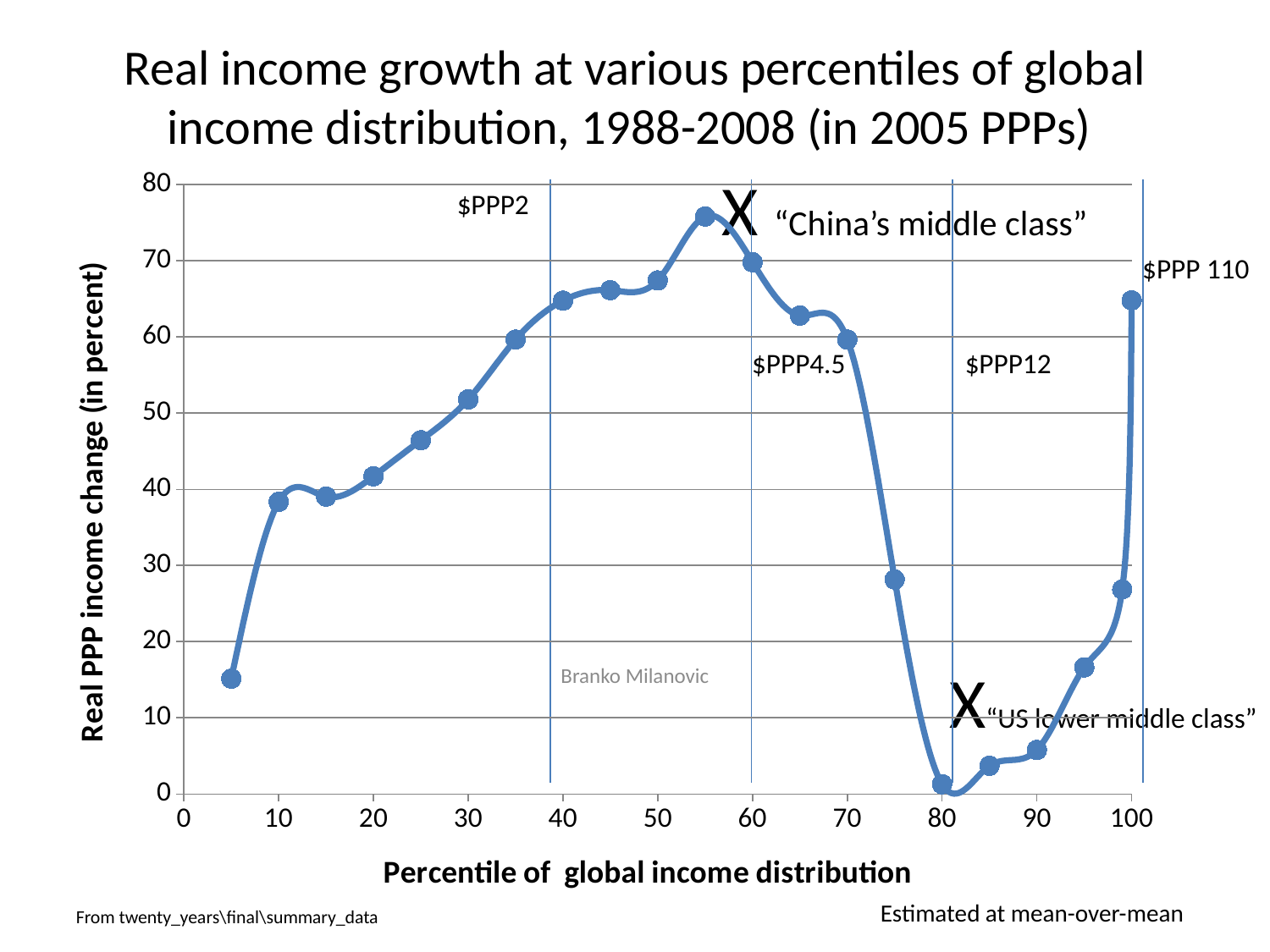
Is the real PPP income change at the 55th percentile greater or less than 70? greater Is the real PPP income change at the 80th percentile greater or less than 10? less At which percentile of the global income distribution is the real PPP income change highest? 55 Is the real PPP income change at the 5th percentile greater or less than 20? less What is the title of the x axis? Percentile of global income distribution Does the real PPP income change rise or fall as the percentile increases from 55 to 80? fall Which has a larger real PPP income change: the 40th percentile or the 90th percentile? 40th percentile What label is attached to the vertical line at roughly the 60th percentile? $PPP4.5 At which percentile of the global income distribution is the real PPP income change lowest? 80 What kind of chart is shown on the slide? line chart